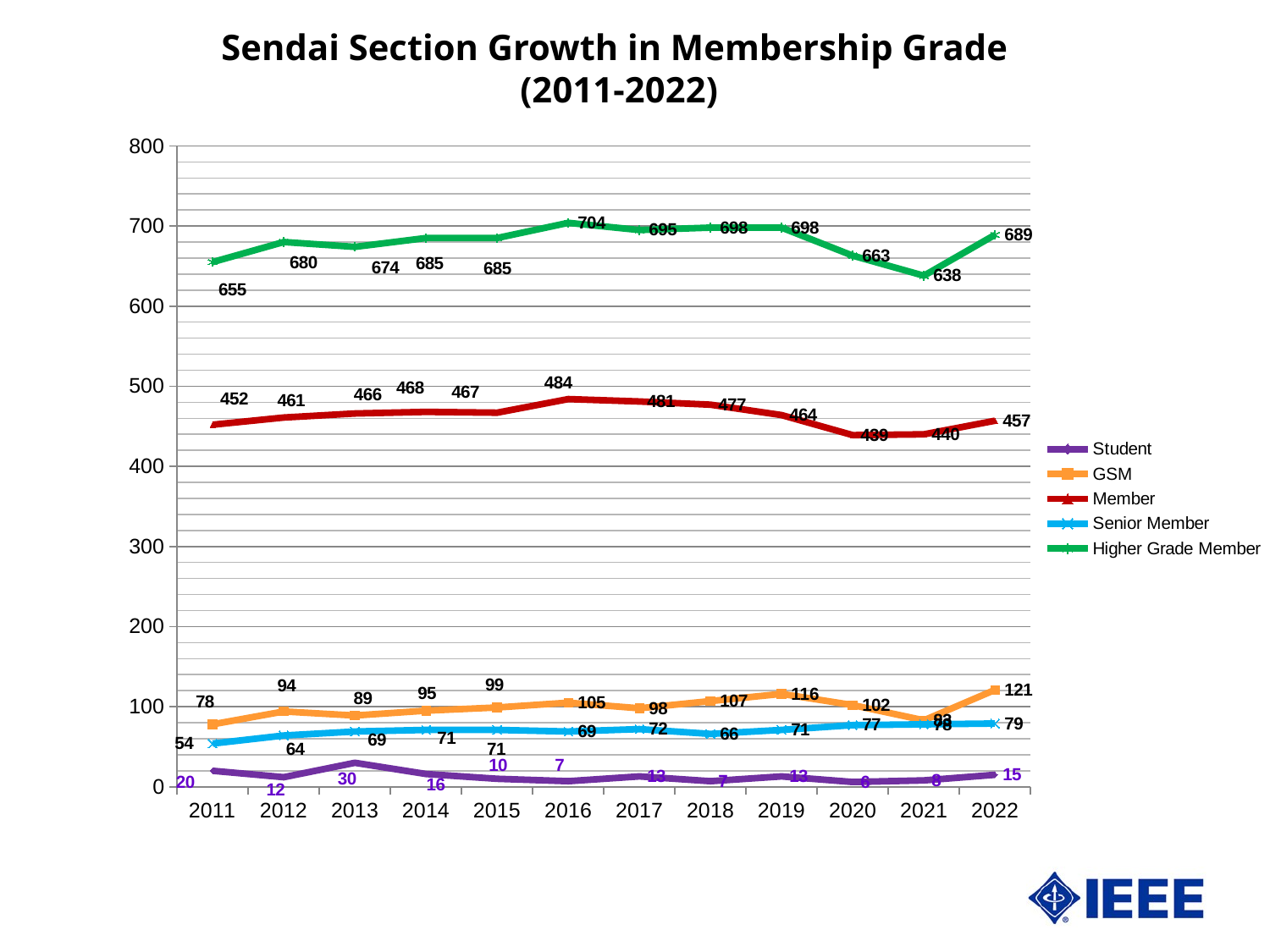
In which year is the Higher Grade Member series at its highest? 2016 Which is larger, the GSM value in 2022 or in 2019? 2022 What is the Senior Member value in 2011? 54 What is the Higher Grade Member value in 2016? 704 In which year is the Higher Grade Member series at its lowest? 2021 How many series does the legend list? 5 What kind of chart is shown on the slide? line chart What is the difference between the Member value in 2016 and in 2020? 45 In which year is the GSM series at its highest? 2022 Does the Higher Grade Member series rise or fall from 2019 to 2021? fall How many years are plotted along the x axis? 12 What is the Student value in 2013? 30